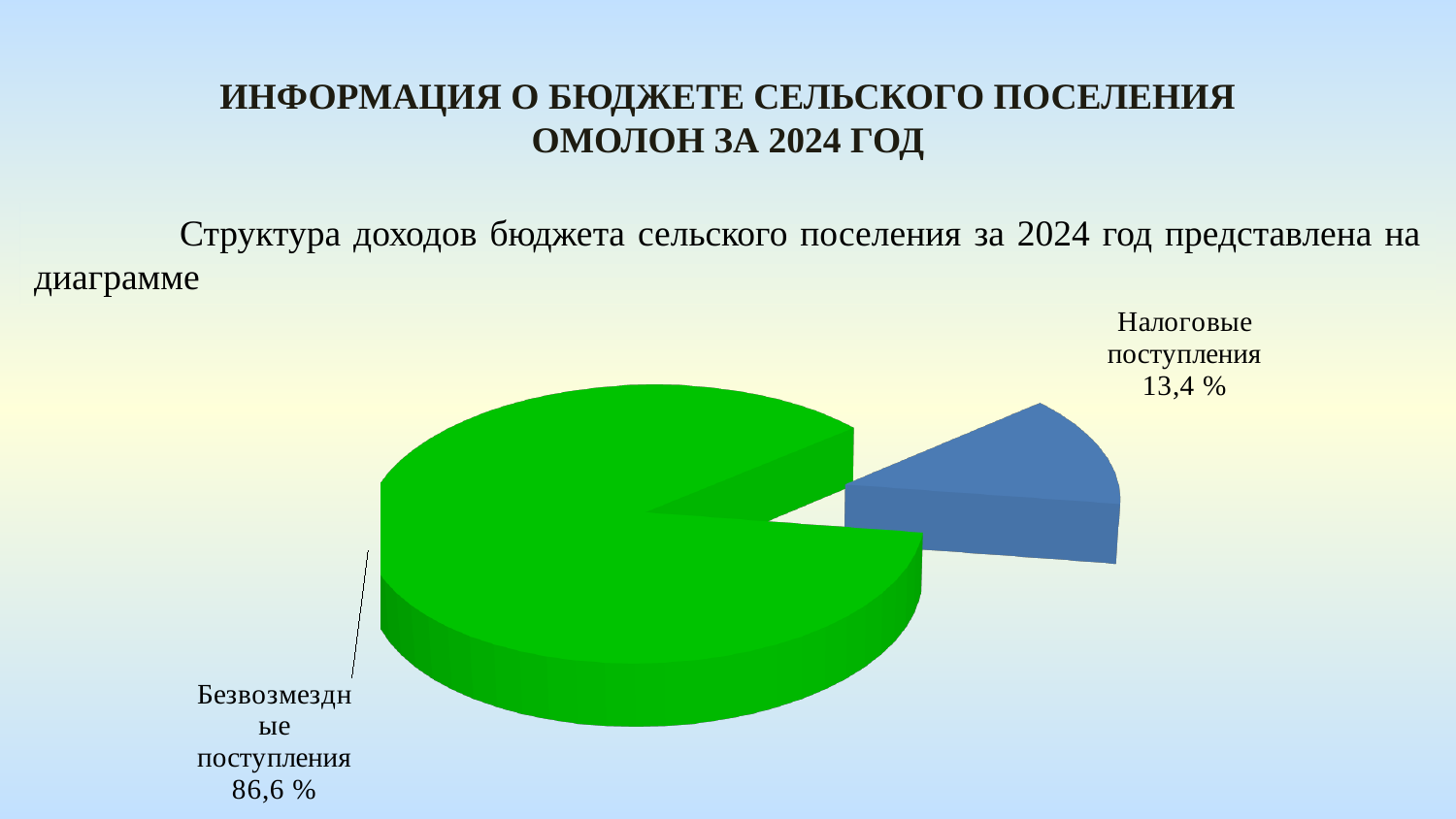
By how many percentage points does Безвозмездные поступления exceed Налоговые поступления? 73,2 What share of the pie is labelled for Безвозмездные поступления? 86,6 % What colour is the slice for Безвозмездные поступления? green Which slice of the pie is the smallest? Налоговые поступления Which is larger: Безвозмездные поступления or Налоговые поступления? Безвозмездные поступления What colour is the slice for Налоговые поступления? blue What kind of chart is shown on the slide? pie chart Is the share for Налоговые поступления greater or less than 50 %? less Which slice of the pie is the largest? Безвозмездные поступления What share of the pie is labelled for Налоговые поступления? 13,4 % How many slices does the pie chart have? 2